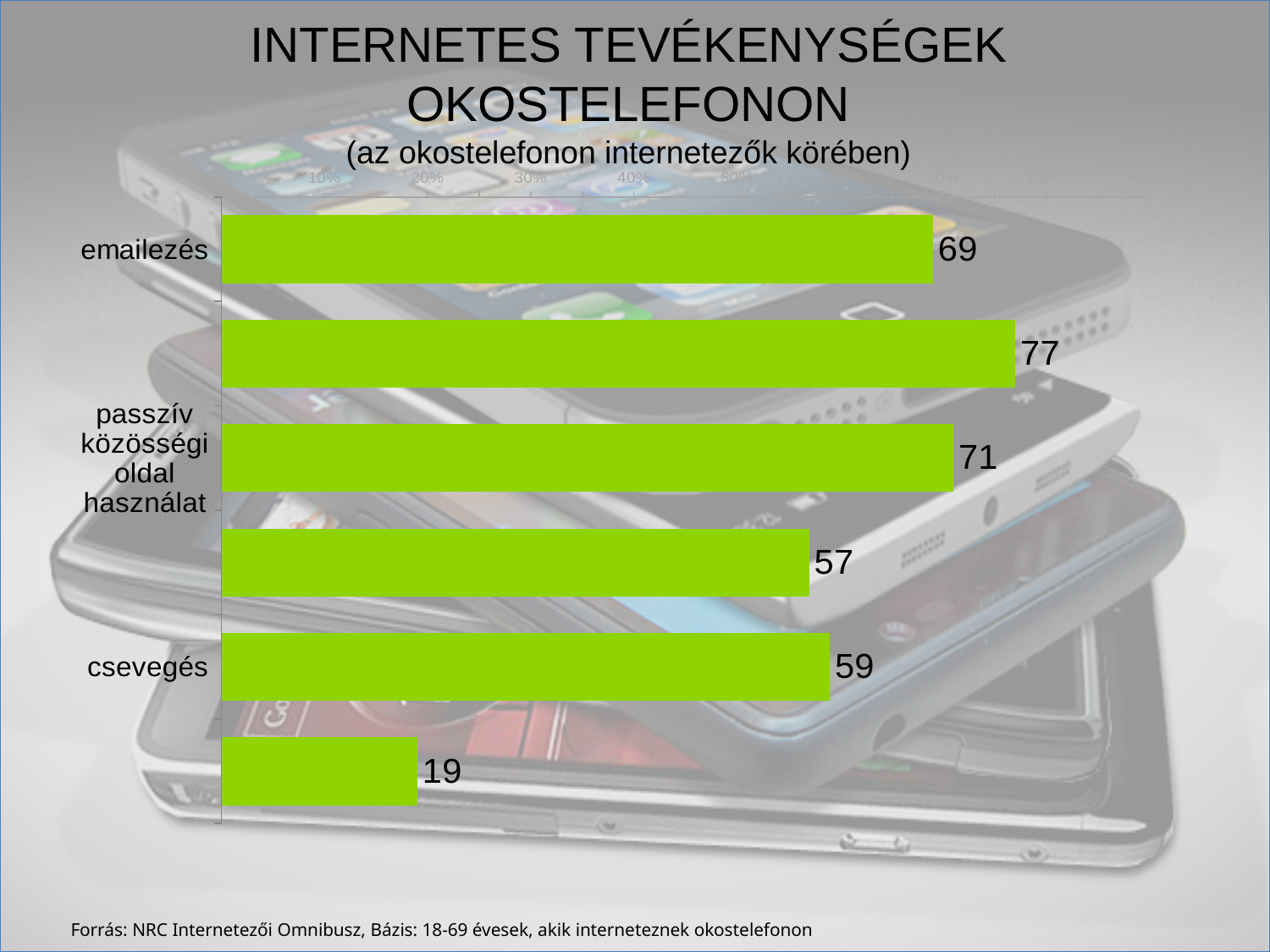
Which is larger, the value for passzív közösségi oldal használat or the value for csevegés? passzív közösségi oldal használat What is the value for passzív közösségi oldal használat? 71 What is the value for csevegés? 59 What is the difference between the values for passzív közösségi oldal használat and emailezés? 2 What is the title of the chart? INTERNETES TEVÉKENYSÉGEK OKOSTELEFONON What is the difference between the values for emailezés and csevegés? 10 Which is larger, the value for emailezés or the value for csevegés? emailezés What is the highest value shown on the chart? 77 What is the value for emailezés? 69 What kind of chart is shown on the slide? bar chart What is the lowest value shown on the chart? 19 How many bars are plotted on the chart? 6